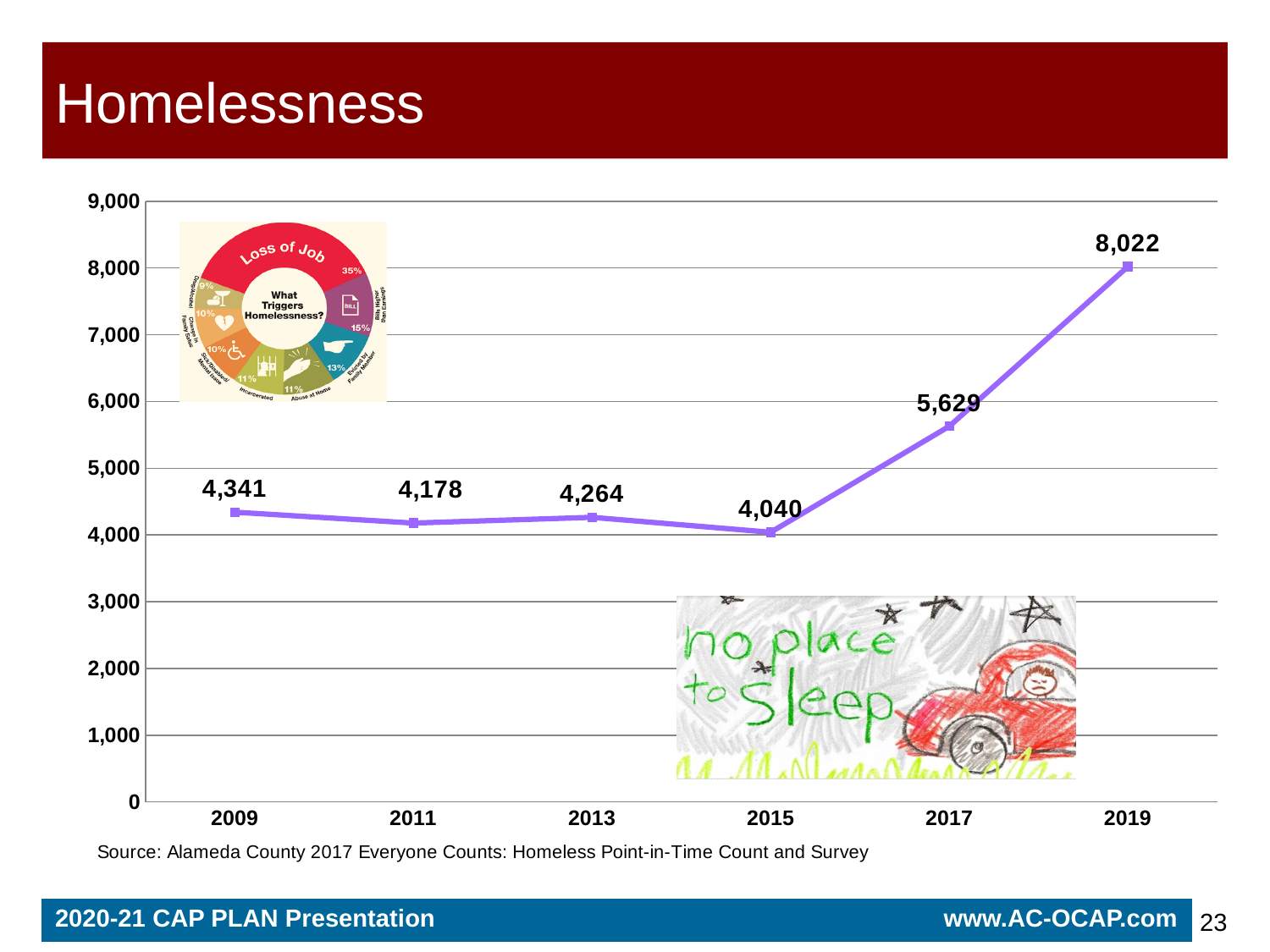
What is the difference between the 2019 value and the 2017 value on the line chart? 2,393 Which year has the highest value on the line chart? 2019 How many years are plotted on the line chart? 6 What kind of chart is used to show the homelessness counts by year? line chart What value is shown for 2019 on the line chart? 8,022 What value is shown for 2015 on the line chart? 4,040 What value is shown for 2009 on the line chart? 4,341 Which is larger on the line chart, the value for 2013 or the value for 2011? 2013 What is the difference between the 2009 value and the 2011 value on the line chart? 163 Does the line chart rise or fall between 2015 and 2019? rise Which year has the lowest value on the line chart? 2015 In the inset pie graphic 'What Triggers Homelessness?', what percentage is shown for Loss of Job? 35%